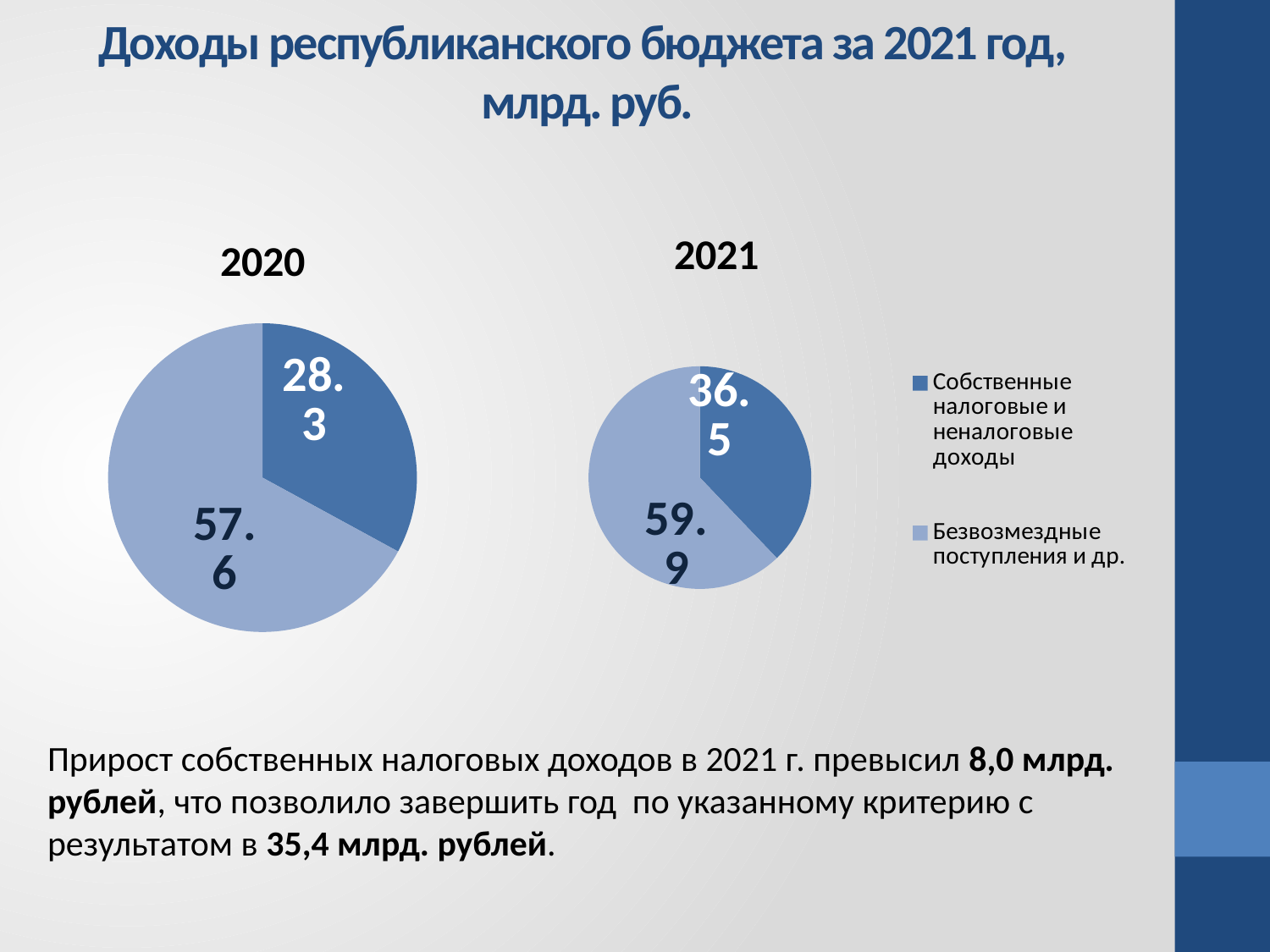
In the 2020 pie chart, what is the value for Безвозмездные поступления и др.? 57.6 In the 2021 pie chart, which slice is the largest? Безвозмездные поступления и др. How many slices does the 2021 pie chart have? 2 How many entries does the legend list? 2 In the 2021 pie chart, what is the value for Безвозмездные поступления и др.? 59.9 In the 2021 pie chart, what is the total of the two slices? 96.4 In the 2020 pie chart, what is the difference between Безвозмездные поступления и др. and Собственные налоговые и неналоговые доходы? 29.3 In the 2021 pie chart, what is the value for Собственные налоговые и неналоговые доходы? 36.5 In the 2020 pie chart, which slice is the smallest? Собственные налоговые и неналоговые доходы In the 2020 pie chart, what is the value for Собственные налоговые и неналоговые доходы? 28.3 Is the value for Собственные налоговые и неналоговые доходы larger in the 2020 chart or the 2021 chart? 2021 What kind of chart is used for the 2020 and 2021 data? Pie chart